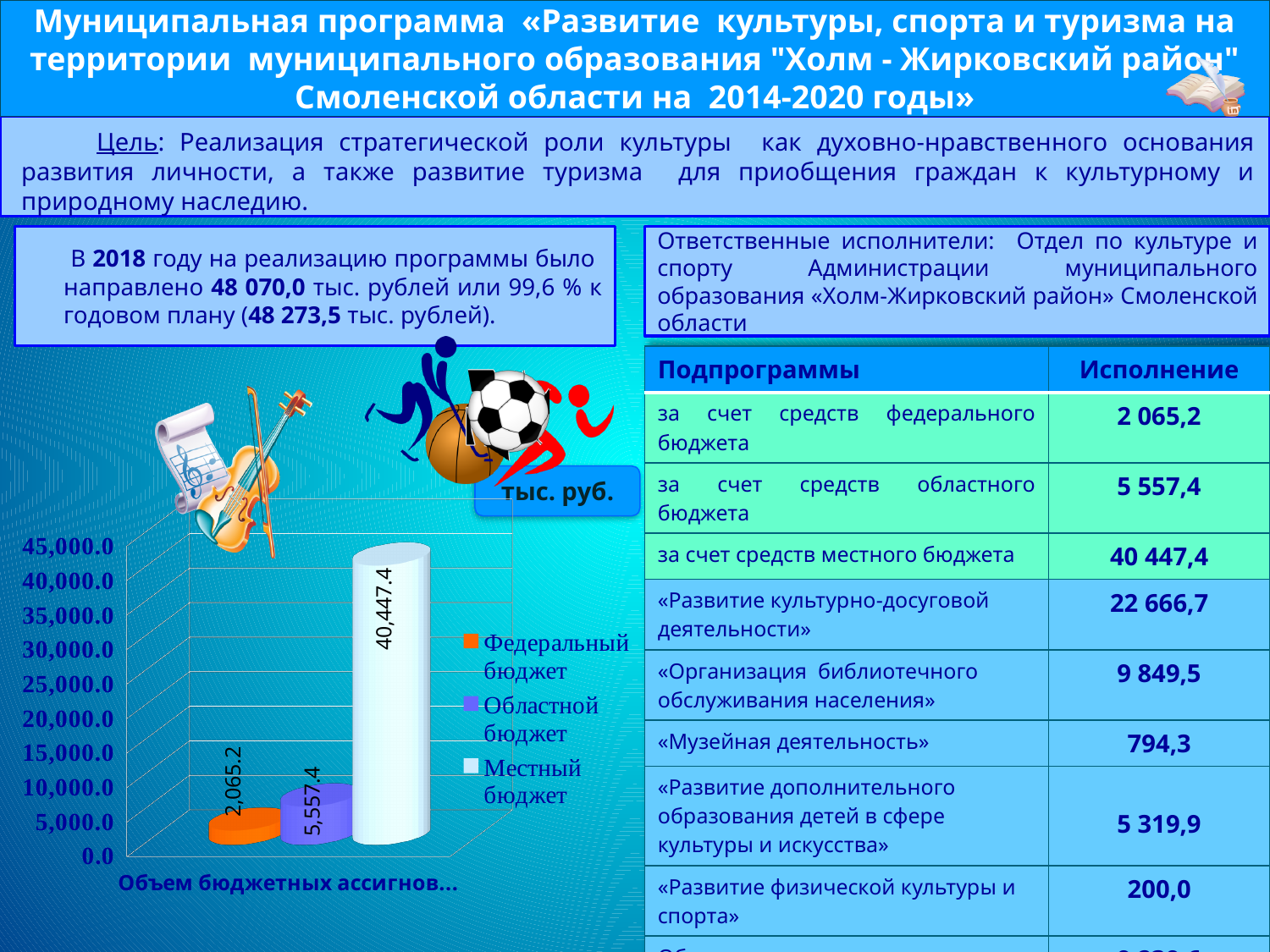
Which is larger, the value for Областной бюджет or the value for Федеральный бюджет? Областной бюджет What unit is indicated in the label above the chart? тыс. руб. Which series has the lowest value in the chart? Федеральный бюджет What is the difference between the values for Областной бюджет and Федеральный бюджет? 3,492.2 How many series does the chart legend list? 3 Is the value for Местный бюджет greater or less than 35,000.0? greater What is the value for Местный бюджет in the chart? 40,447.4 What type of chart is shown on the slide? bar chart What is the value for Федеральный бюджет in the chart? 2,065.2 Which series has the highest value in the chart? Местный бюджет What is the difference between the values for Местный бюджет and Областной бюджет? 34,890.0 What is the value for Областной бюджет in the chart? 5,557.4